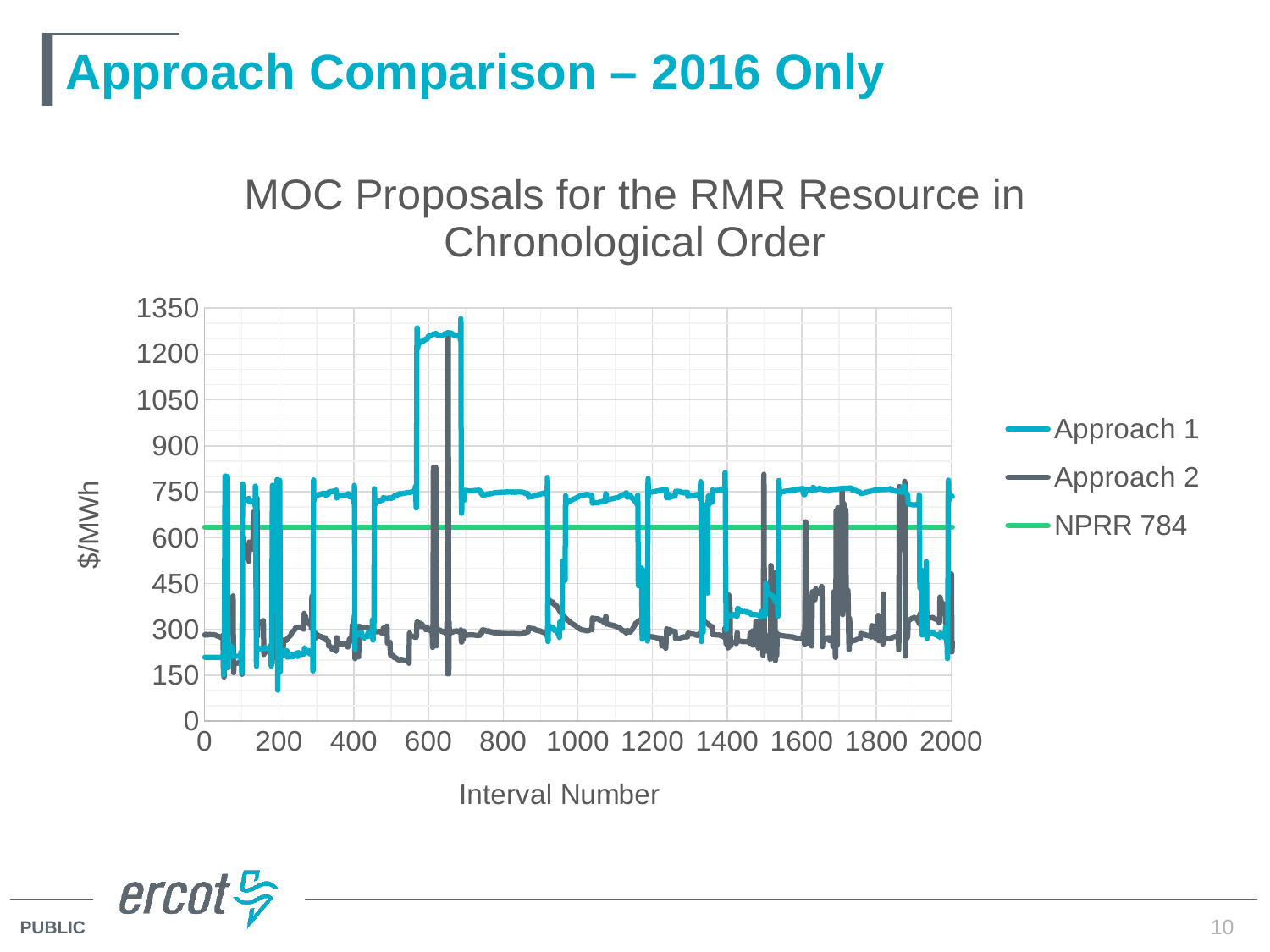
Is the value of Approach 2 around interval 800 greater or less than 450? less Is the peak value of Approach 1 around interval 600 greater or less than 1200? greater What is the title of the chart? MOC Proposals for the RMR Resource in Chronological Order Is the value of the NPRR 784 line greater or less than 750? less How many series does the legend list? 3 What is the highest tick value shown on the vertical axis? 1350 Which series stays constant across all interval numbers? NPRR 784 Which series reaches the highest value on the chart? Approach 1 What kind of chart is shown on the slide? Line chart Around interval 1000, which series has the larger value, Approach 1 or Approach 2? Approach 1 What is the label of the vertical axis? $/MWh